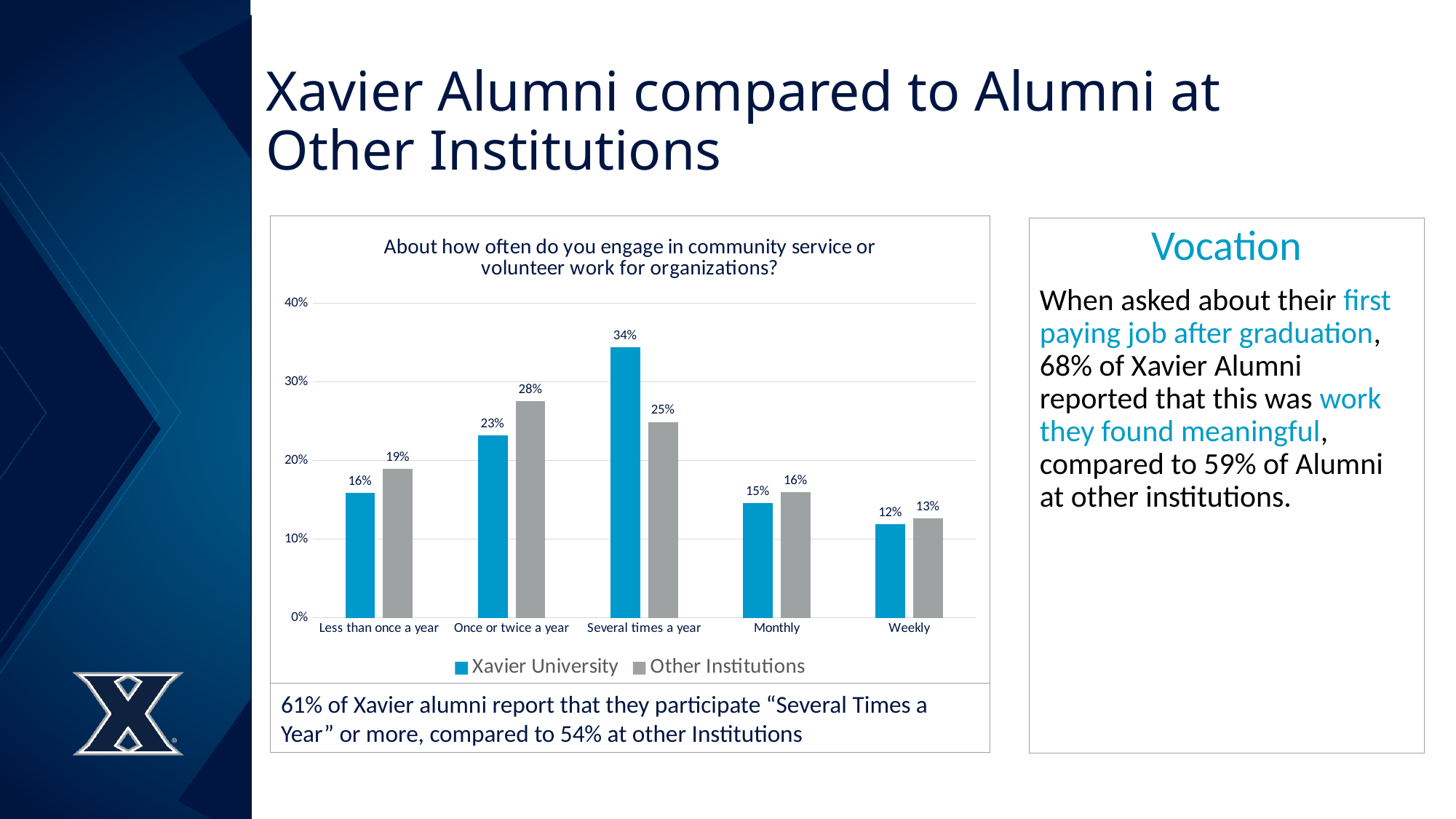
Which category has the lowest value for Other Institutions? Weekly Which category has the highest value for Xavier University? Several times a year What percentage of Xavier University alumni report engaging in community service several times a year? 34% What kind of chart is shown on the slide? Bar chart What is the difference between Xavier University and Other Institutions for the 'Several times a year' category? 9% What percentage of alumni at Other Institutions report engaging in community service once or twice a year? 28% What percentage of Xavier University alumni report engaging in community service weekly? 12% Which colour represents Xavier University in the chart? Blue How many categories are shown on the x axis of the chart? 5 How many series does the chart's legend list? 2 For the 'Once or twice a year' category, which series has the larger value, Xavier University or Other Institutions? Other Institutions Is the value for Xavier University in the 'Monthly' category greater or less than 20%? less